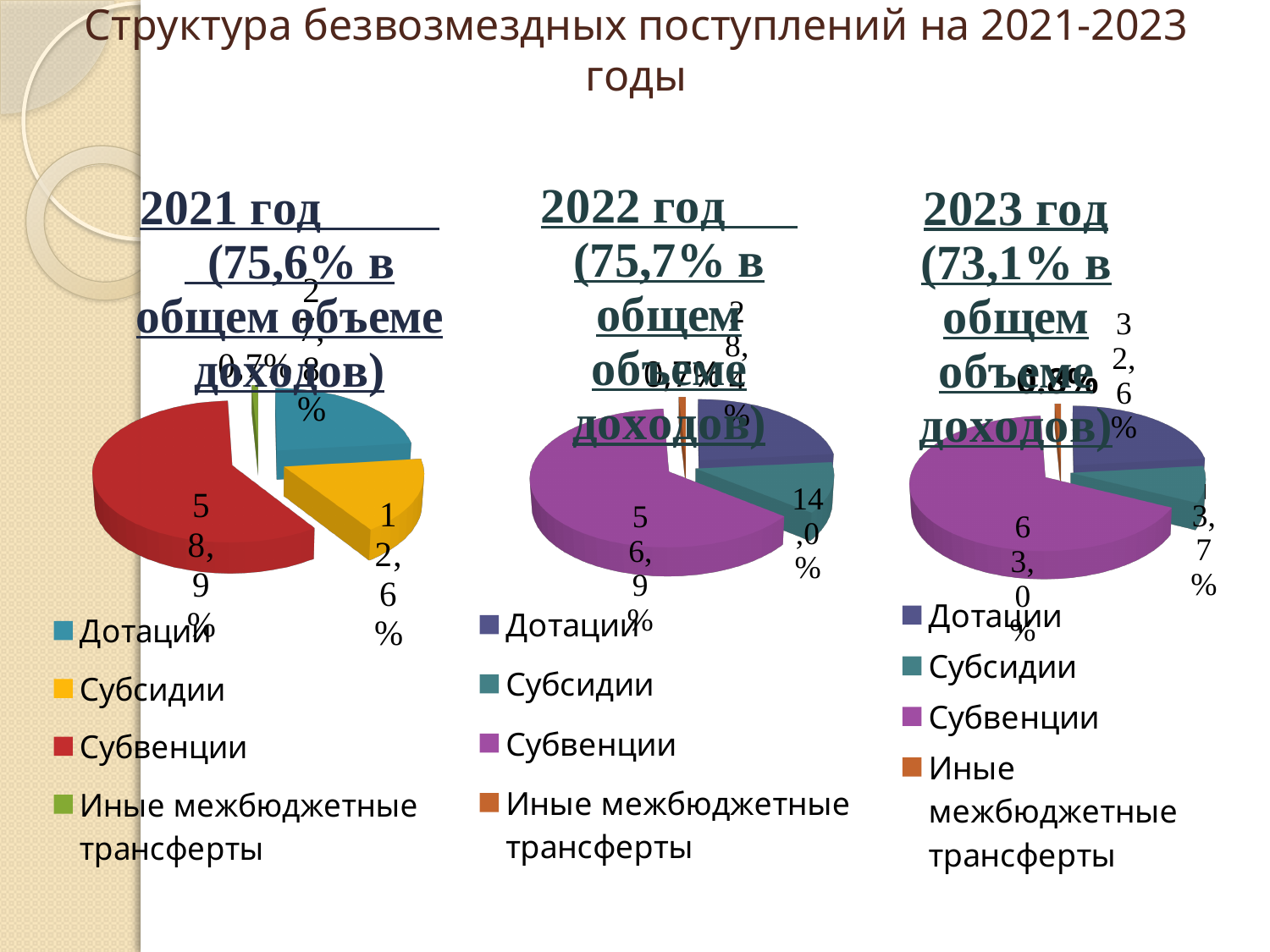
In the 2023 год pie chart, what share is shown for Дотации? 32,6% In the 2022 год pie chart, what share is shown for Субвенции? 56,9% In the 2021 год pie chart, which category has the smallest slice? Иные межбюджетные трансферты In the 2021 год pie chart, what is the difference in percentage points between Субвенции and Субсидии? 46,3 What type of chart is used for the 2021 год data? Pie chart In the 2022 год pie chart, what share is shown for Субсидии? 14,0% In the 2021 год pie chart, what share is shown for Субсидии? 12,6% In the 2022 год pie chart, which is larger: Субсидии or Субвенции? Субвенции In the 2021 год pie chart, what share is shown for Субвенции? 58,9% How many categories does the legend of the 2022 год chart list? 4 In the 2023 год pie chart, what share is shown for Субвенции? 63,0% In the 2023 год pie chart, which category has the largest slice? Субвенции